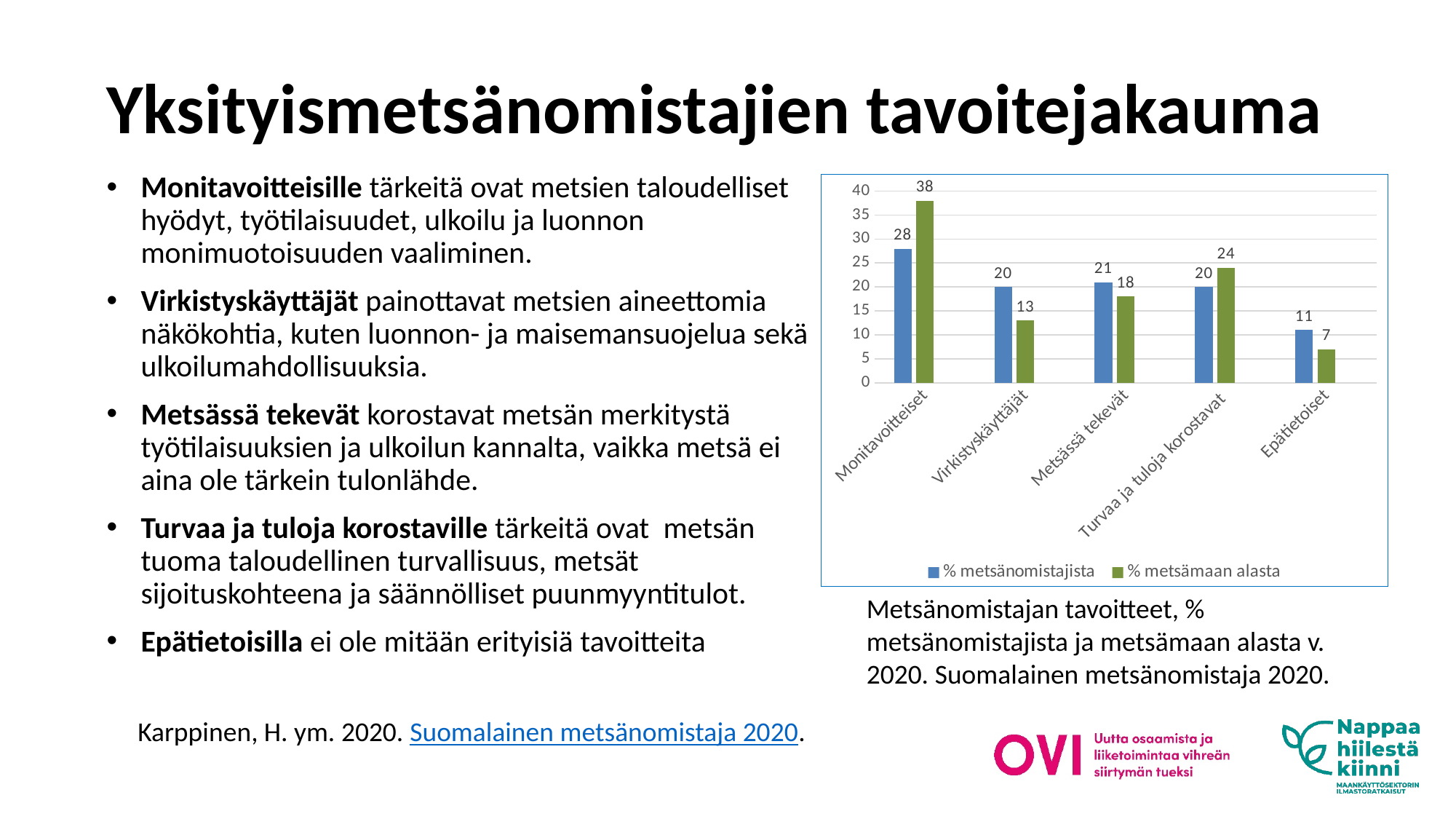
How many series does the legend list? 2 What is the difference between % metsänomistajista and % metsämaan alasta for Virkistyskäyttäjät? 7 What kind of chart is shown on the slide? Bar chart What is the value of % metsämaan alasta for Turvaa ja tuloja korostavat? 24 What is the value of % metsämaan alasta for Epätietoiset? 7 For Virkistyskäyttäjät, which is larger: % metsänomistajista or % metsämaan alasta? % metsänomistajista How many categories are shown on the x axis? 5 Which category has the highest value for % metsämaan alasta? Monitavoitteiset What is the difference between % metsämaan alasta and % metsänomistajista for Monitavoitteiset? 10 Which category has the lowest value for % metsänomistajista? Epätietoiset What is the value of % metsänomistajista for Monitavoitteiset? 28 Which colour represents % metsämaan alasta in the chart? Green